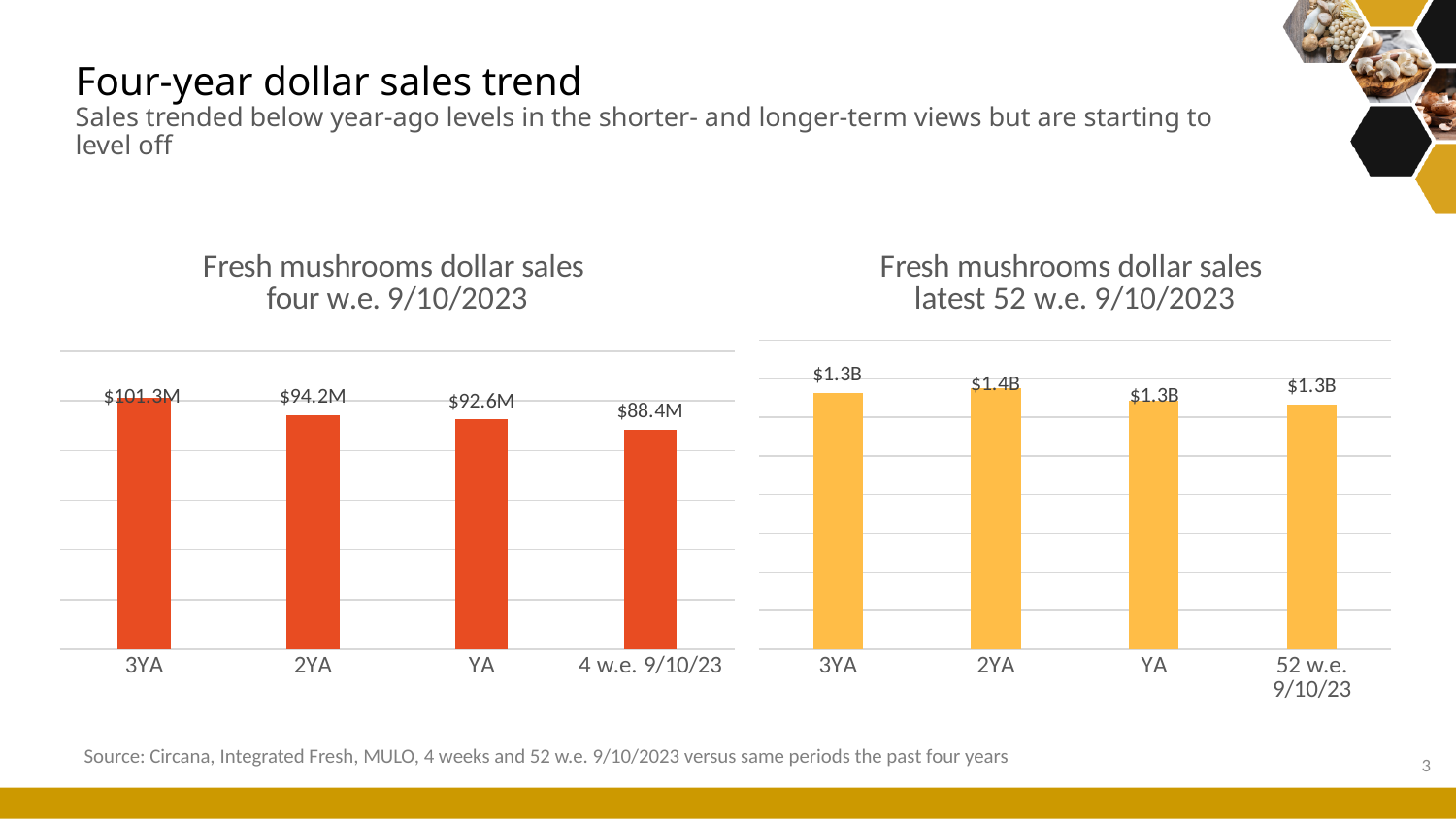
What kind of chart is the chart on the left of the slide? bar chart In the chart titled "Fresh mushrooms dollar sales latest 52 w.e. 9/10/2023", which category has the highest value? 2YA In the chart titled "Fresh mushrooms dollar sales four w.e. 9/10/2023", which category has the highest value? 3YA In the chart titled "Fresh mushrooms dollar sales four w.e. 9/10/2023", what is the value for YA? $92.6M In the chart titled "Fresh mushrooms dollar sales four w.e. 9/10/2023", do the values rise or fall from 3YA to 4 w.e. 9/10/23? fall In the chart titled "Fresh mushrooms dollar sales four w.e. 9/10/2023", what is the value for 3YA? $101.3M In the chart titled "Fresh mushrooms dollar sales four w.e. 9/10/2023", what is the value for 4 w.e. 9/10/23? $88.4M In the chart titled "Fresh mushrooms dollar sales four w.e. 9/10/2023", what is the difference between the 3YA value and the 4 w.e. 9/10/23 value? $12.9M In the chart titled "Fresh mushrooms dollar sales four w.e. 9/10/2023", which category has the lowest value? 4 w.e. 9/10/23 In the chart titled "Fresh mushrooms dollar sales latest 52 w.e. 9/10/2023", what is the value for 2YA? $1.4B How many categories are shown in the chart titled "Fresh mushrooms dollar sales latest 52 w.e. 9/10/2023"? 4 In the chart titled "Fresh mushrooms dollar sales latest 52 w.e. 9/10/2023", what is the value for 52 w.e. 9/10/23? $1.3B